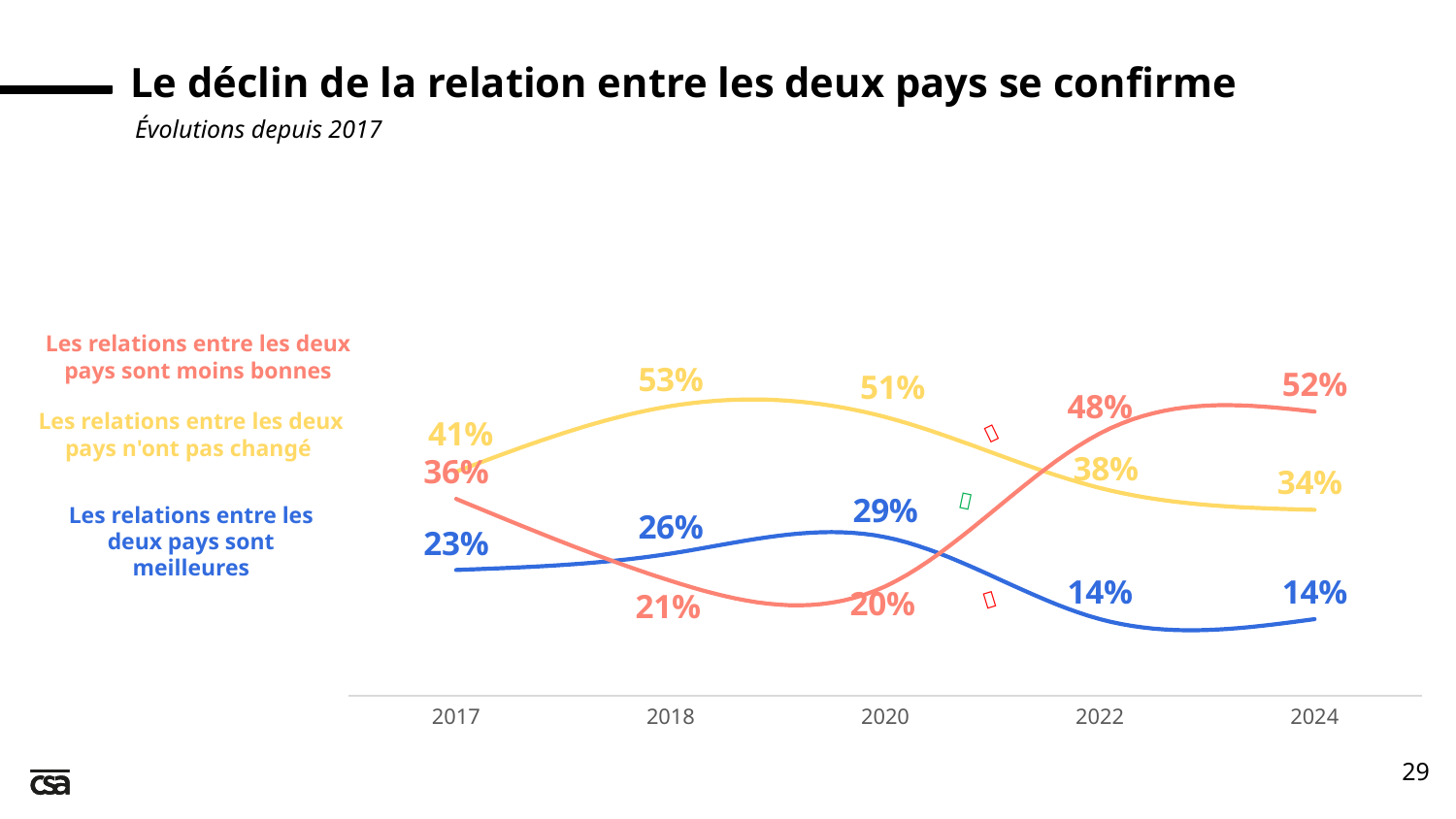
What is the value for "Les relations entre les deux pays sont meilleures" in 2020? 29% Does the value for "Les relations entre les deux pays n'ont pas changé" rise or fall between 2018 and 2024? fall How many years are shown on the x axis of the chart? 5 In 2022, which series has the larger value: "moins bonnes" or "n'ont pas changé"? Les relations entre les deux pays sont moins bonnes How many series does the chart show? 3 What is the value for "Les relations entre les deux pays sont moins bonnes" in 2024? 52% In which year is the value for "Les relations entre les deux pays sont moins bonnes" lowest? 2020 What is the difference between the 2024 and 2017 values for "Les relations entre les deux pays sont moins bonnes"? 16 percentage points In which year is the value for "Les relations entre les deux pays n'ont pas changé" highest? 2018 What is the title of the chart on the slide? Le déclin de la relation entre les deux pays se confirme What is the value for "Les relations entre les deux pays n'ont pas changé" in 2018? 53% What type of chart is shown on the slide? line chart